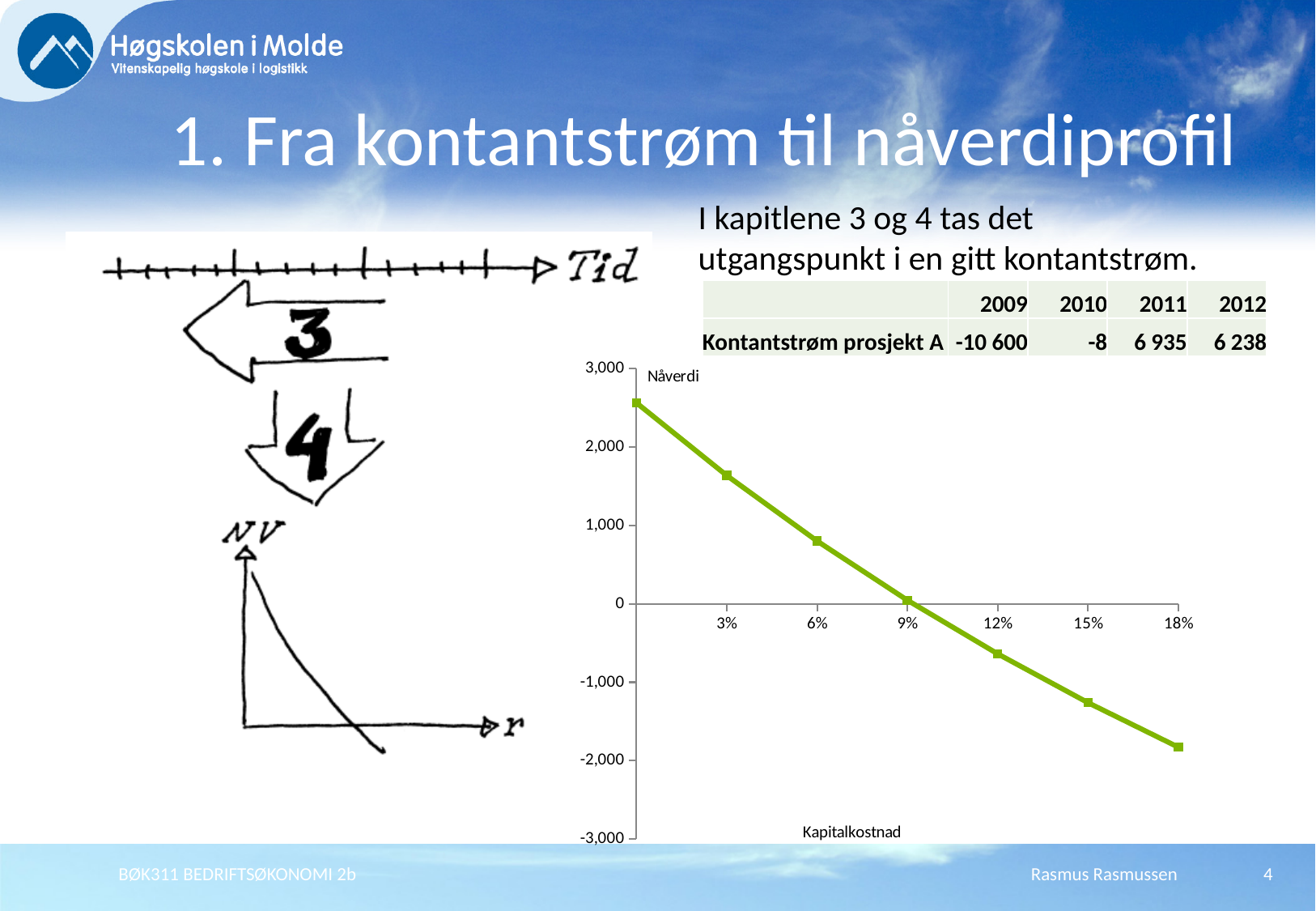
Is the Nåverdi value at 18% greater or less than -2,000? greater Is the Nåverdi value at 3% greater or less than 1,000? greater Does the Nåverdi value rise or fall as Kapitalkostnad increases along the x axis? fall At which Kapitalkostnad value on the x axis is Nåverdi lowest? 18% What is the label of the vertical axis of the chart? Nåverdi What kind of chart is shown on the slide? line chart Is the Nåverdi value at the leftmost point (0%) greater or less than 2,000? greater Which is larger, the Nåverdi value at 6% or at 12%? 6% How many data points are marked on the Nåverdi line? 7 What is the label of the horizontal axis of the chart? Kapitalkostnad